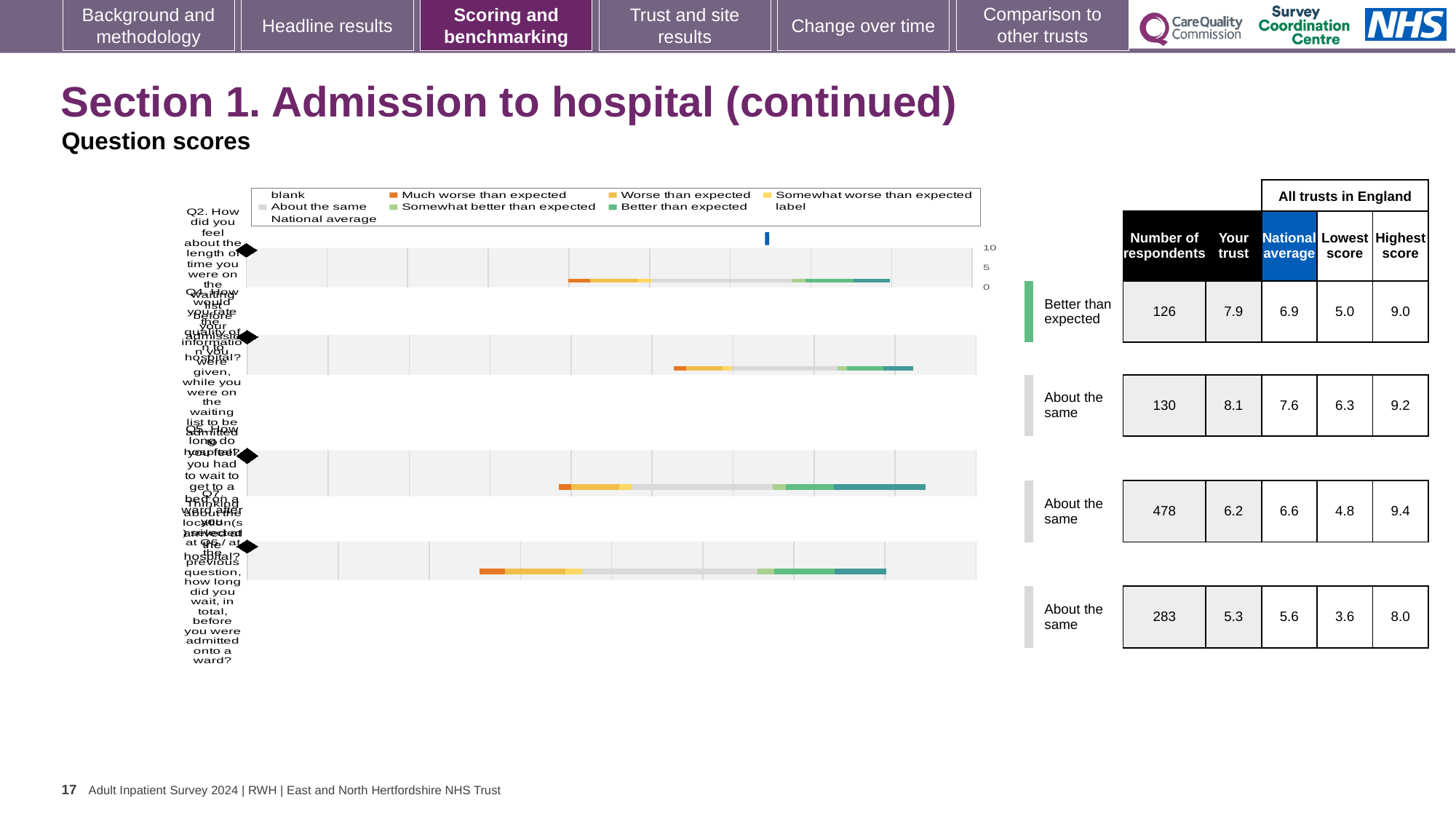
What is the maximum value shown on the chart's score axis? 10 In the table beside the chart, what is the lowest 'Lowest score' value listed? 3.6 In the table beside the chart, what is the national average for the row rated 'Better than expected'? 6.9 In the table beside the chart, what is the highest 'Highest score' value listed? 9.4 In the table beside the chart, by how much does the 'Your trust' score exceed the national average in the row rated 'Better than expected'? 1.0 In the table beside the chart, how many respondents are listed for the row rated 'Better than expected'? 126 In the table beside the chart, what is the 'Your trust' score for the row rated 'Better than expected'? 7.9 In the table beside the chart, which row has the highest number of respondents? The third row, rated 'About the same' (478 respondents) How many horizontal bars are plotted in the chart? 4 What kind of chart is shown on the slide? bar chart In the table beside the chart, for the row with 283 respondents, is the 'Your trust' score or the national average larger? National average